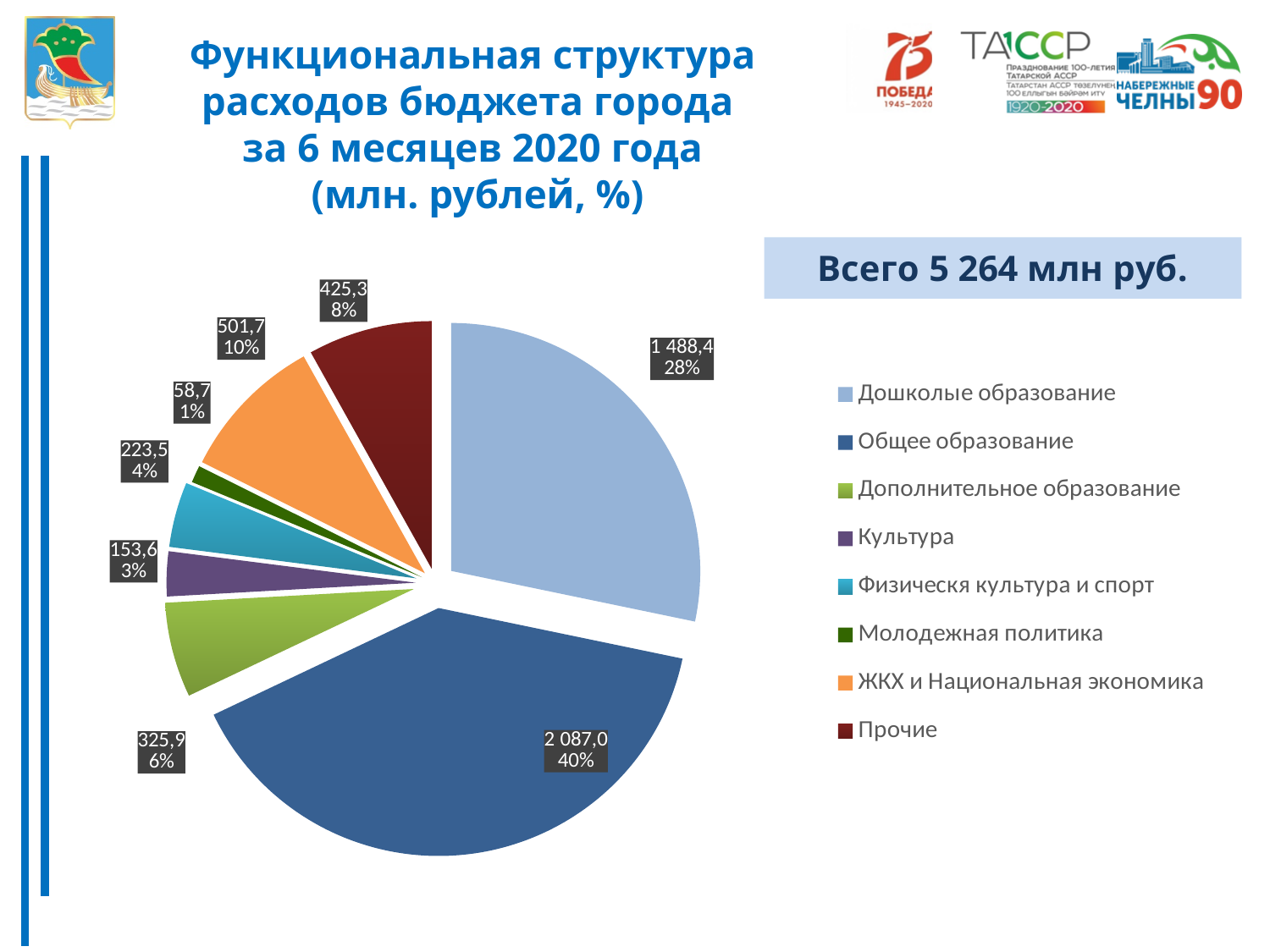
What kind of chart is shown on the slide? Pie chart How many categories does the legend of the pie chart list? 8 What share of the pie does Молодежная политика take? 1% What is the difference between the values for Общее образование and Дошколые образование? 598,6 What share of the pie does Дошколые образование take? 28% What is the value for ЖКХ и Национальная экономика? 501,7 What total amount is stated on the slide for the budget expenditures? 5 264 млн руб. What is the value for Культура? 153,6 Which is larger, the value for Прочие or the value for Дополнительное образование? Прочие What is the value for Общее образование? 2 087,0 Which category has the largest slice of the pie? Общее образование Which category has the smallest slice of the pie? Молодежная политика